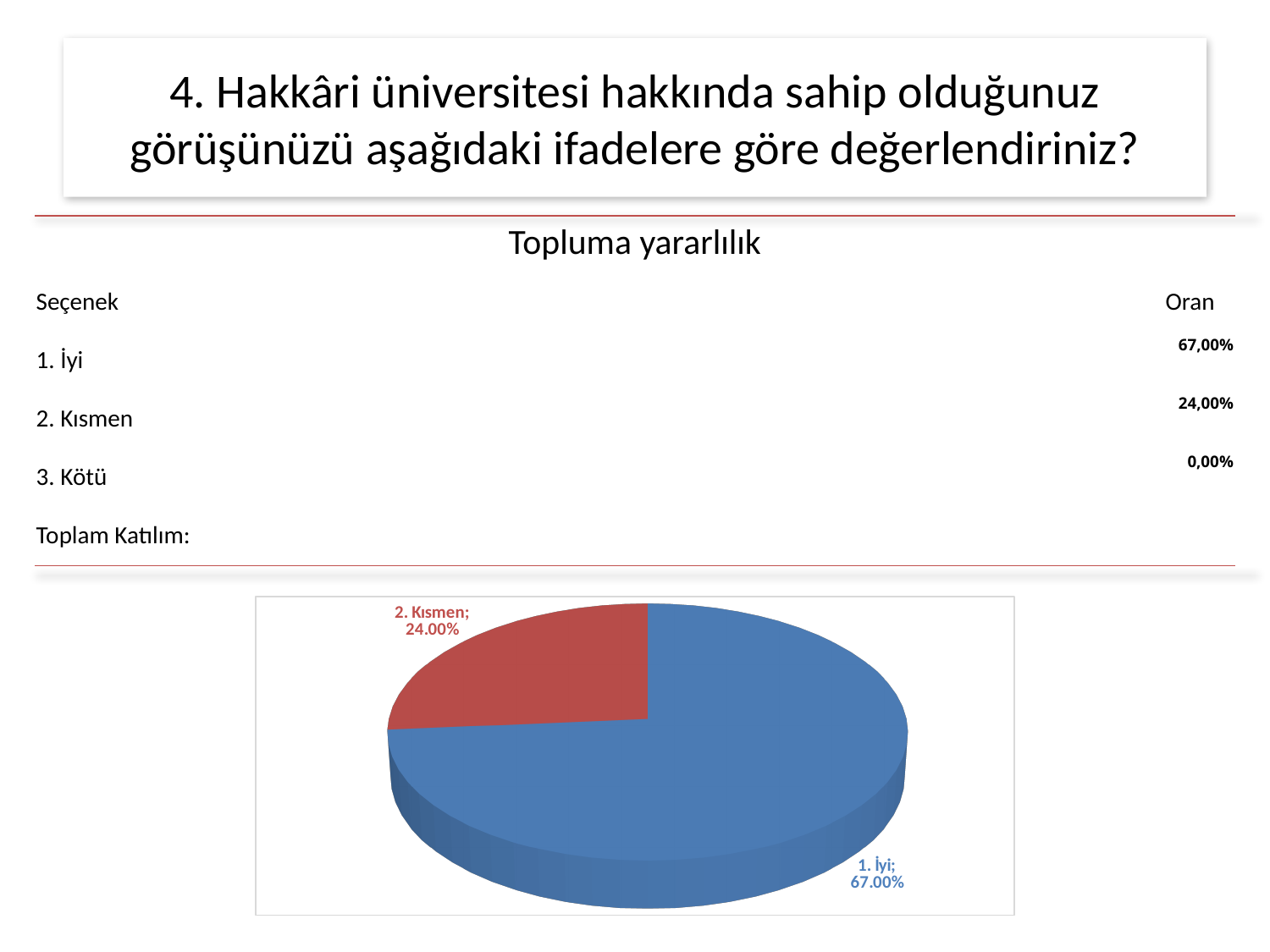
What colour is the "2. Kısmen" slice in the pie chart? red What share of the pie does the "2. Kısmen" slice represent? 24.00% Which is larger in the pie chart, the slice for "1. İyi" or the slice for "2. Kısmen"? 1. İyi How many slices in the pie chart have data labels? 2 What is the difference between the "1. İyi" slice and the "2. Kısmen" slice in the pie chart? 43.00% What is the value shown for the slice labelled "2. Kısmen" in the pie chart? 24.00% What colour is the "1. İyi" slice in the pie chart? blue Which slice of the pie chart is the largest? 1. İyi Which labelled slice of the pie chart is the smallest? 2. Kısmen What is the value shown for the slice labelled "1. İyi" in the pie chart? 67.00% What kind of chart is shown on the slide? pie chart